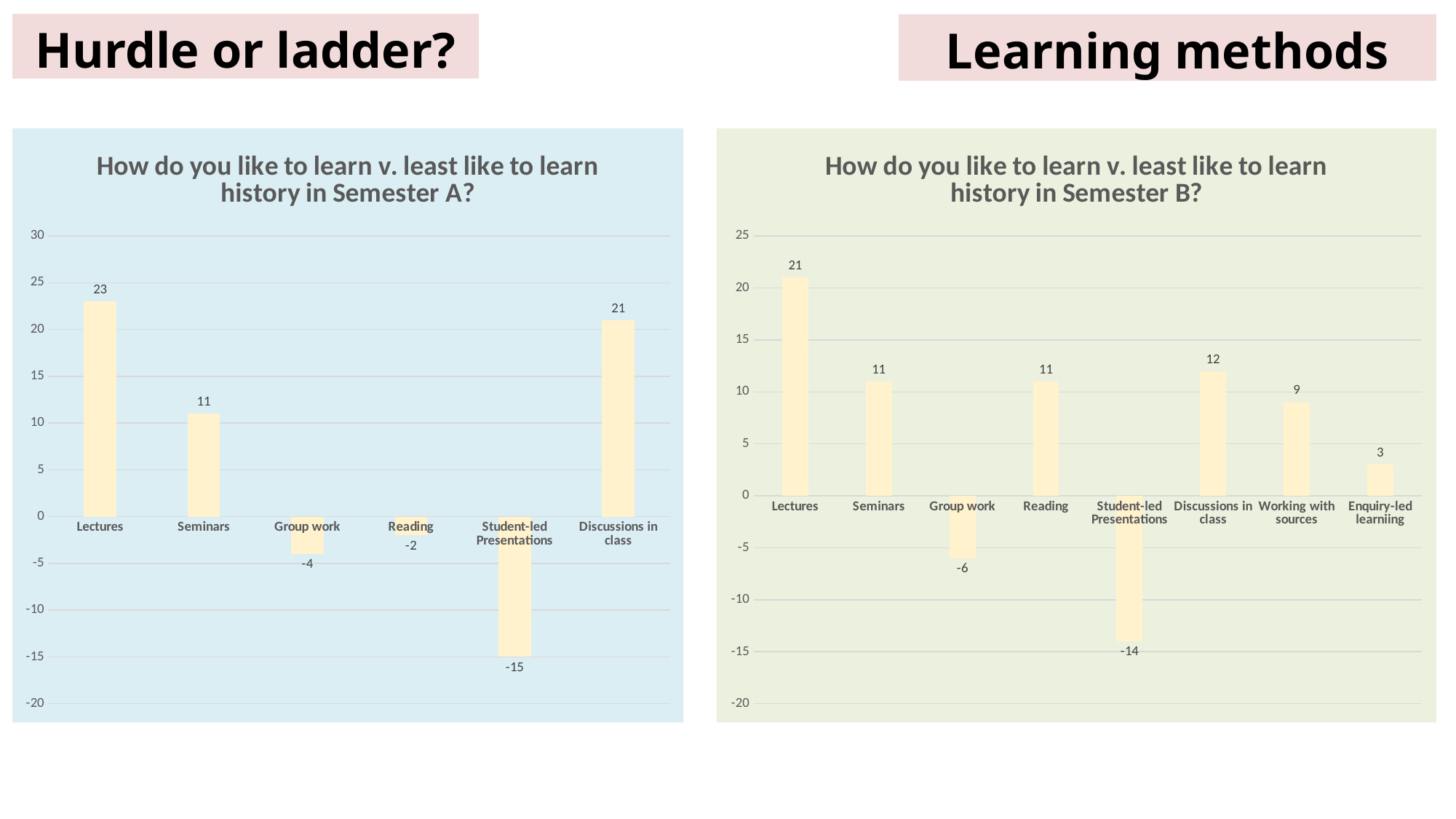
In the Semester A chart, what is the value for Lectures? 23 In the Semester A chart, which category has the highest value? Lectures What kind of chart is the Semester B chart? Bar chart In the Semester A chart, what is the value for Student-led Presentations? -15 In the Semester B chart, how many categories are shown? 8 In the Semester B chart, which is larger, the value for Discussions in class or the value for Enquiry-led learning? Discussions in class In the Semester A chart, what is the difference between the values for Lectures and Discussions in class? 2 In the Semester B chart, what is the value for Group work? -6 In the Semester A chart, which category has the lowest value? Student-led Presentations In the Semester B chart, what is the value for Working with sources? 9 In the Semester B chart, which category has the lowest value? Student-led Presentations In the Semester A chart, how many categories are shown? 6